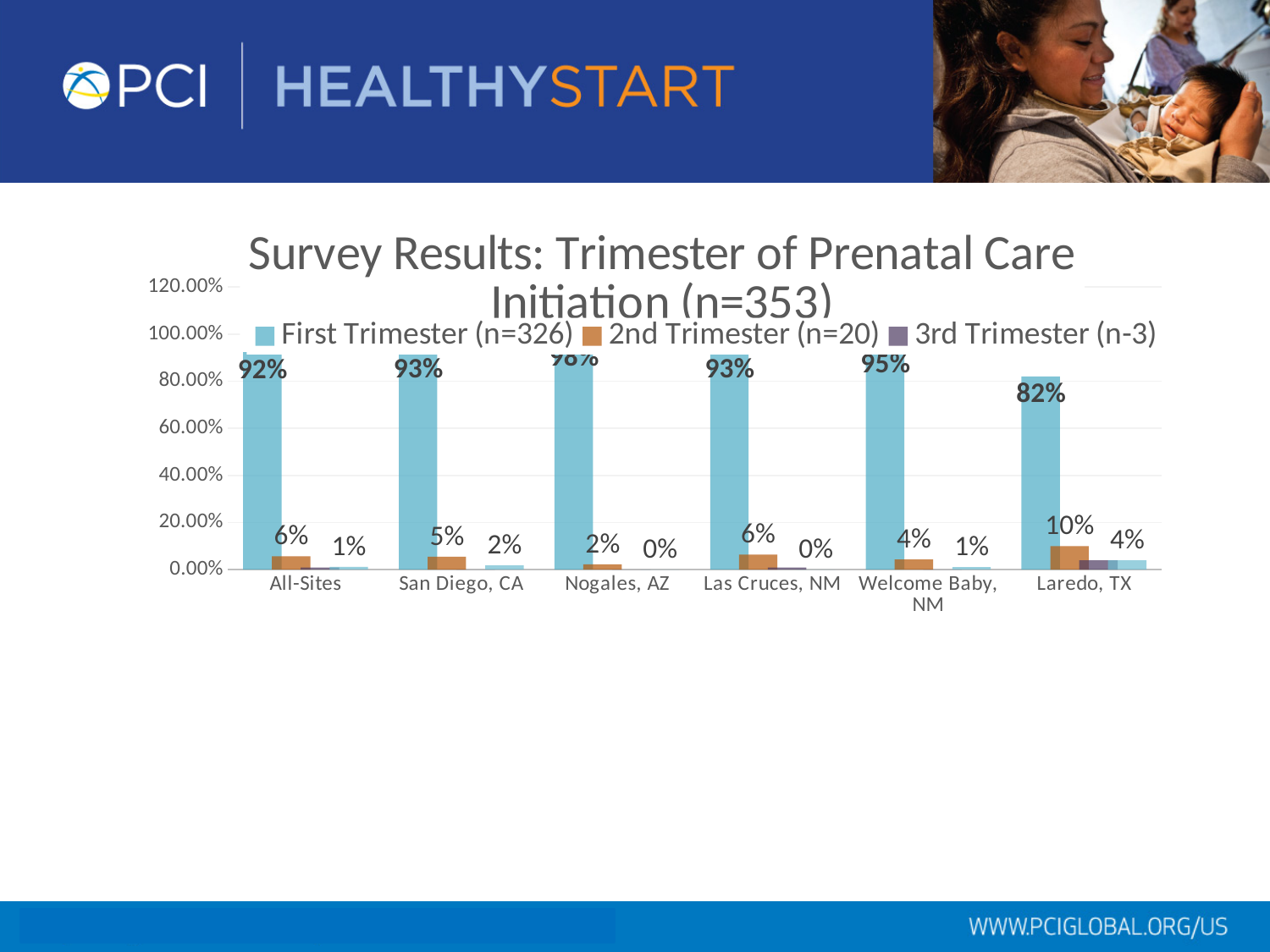
Which site has the lowest First Trimester value? Laredo, TX What kind of chart is shown on the slide? bar chart Which is larger, the 2nd Trimester value for All-Sites or for San Diego, CA? All-Sites Which site has the highest 2nd Trimester value? Laredo, TX What is the First Trimester value for Welcome Baby, NM? 95% How many sites (categories) are shown on the x axis? 6 How many series does the legend list? 3 Is the First Trimester value for Nogales, AZ greater or less than 80.00%? greater What is the First Trimester value for All-Sites? 92% What is the difference between the First Trimester values for Welcome Baby, NM and Laredo, TX? 13 percentage points What is the 2nd Trimester value for Laredo, TX? 10%